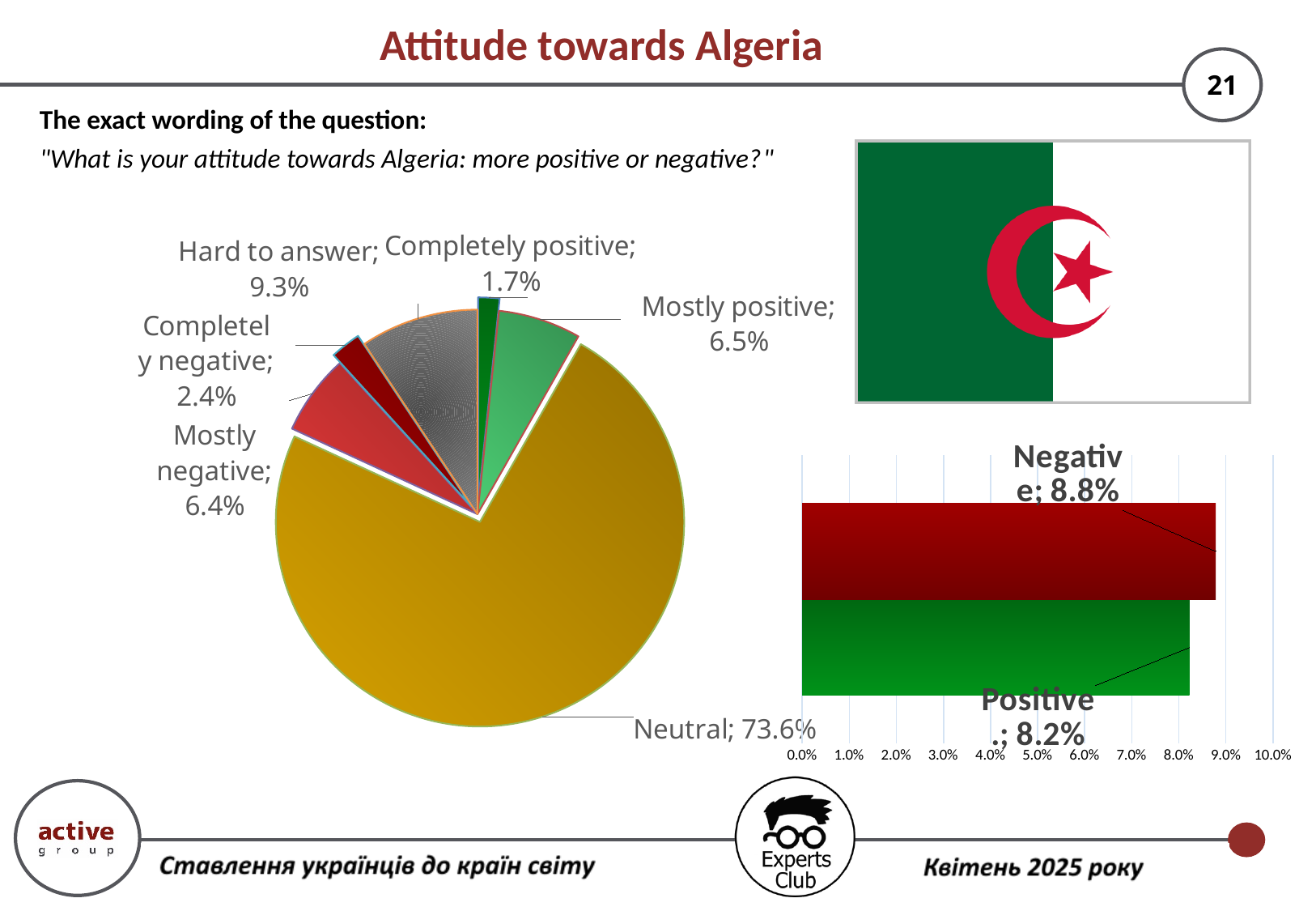
In the pie chart, what is the difference between Mostly negative and Completely negative? 4.0% In the bar chart on the right, what is the difference between Negative and Positive? 0.6% In the pie chart, what is the value for Mostly positive? 6.5% In the pie chart, which category has the smallest share? Completely positive In the pie chart, what share of respondents answered Neutral? 73.6% How many categories does the pie chart show? 6 In the pie chart, which category has the largest share? Neutral In the pie chart, what is the value for Completely negative? 2.4% In the pie chart, what is the value for Hard to answer? 9.3% In the bar chart on the right, what is the value for Negative? 8.8% In the pie chart, which is larger: Mostly positive or Mostly negative? Mostly positive What type of chart is shown on the right side of the slide below the flag? Bar chart